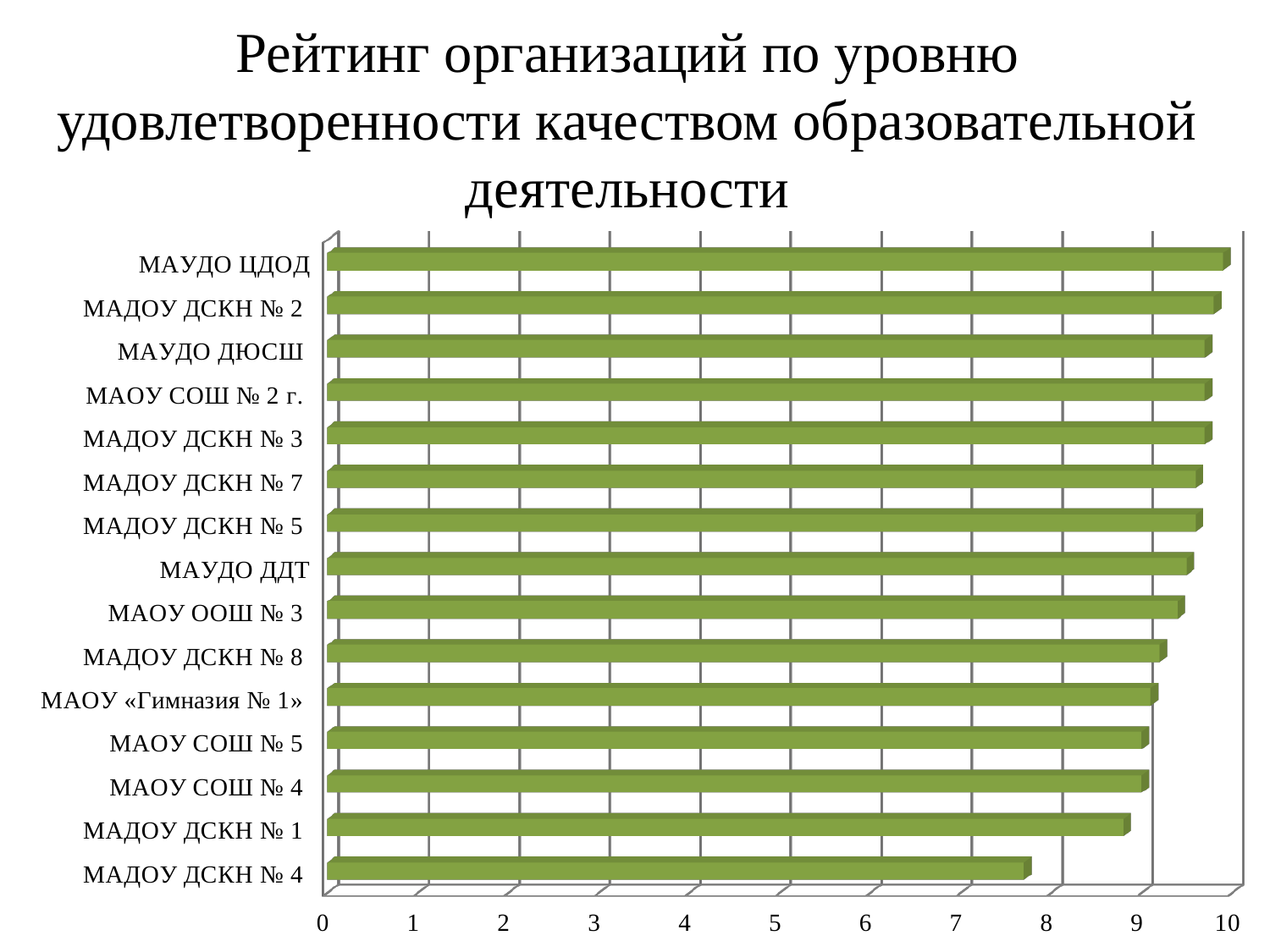
Is the value for МАУДО ЦДОД greater or less than 9? greater How many organisations are listed on the chart? 15 What kind of chart is shown on the slide? bar chart Is the value for МАОУ ООШ № 3 greater or less than 9? greater Which has the larger value, МАУДО ДДТ or МАДОУ ДСКН № 8? МАУДО ДДТ What is the maximum value shown on the horizontal axis of the chart? 10 Which has the larger value, МАДОУ ДСКН № 1 or МАДОУ ДСКН № 4? МАДОУ ДСКН № 1 Which organisation has the lowest value on the chart? МАДОУ ДСКН № 4 Is the value for МАДОУ ДСКН № 4 greater or less than 7? greater What colour are the bars in the chart? green